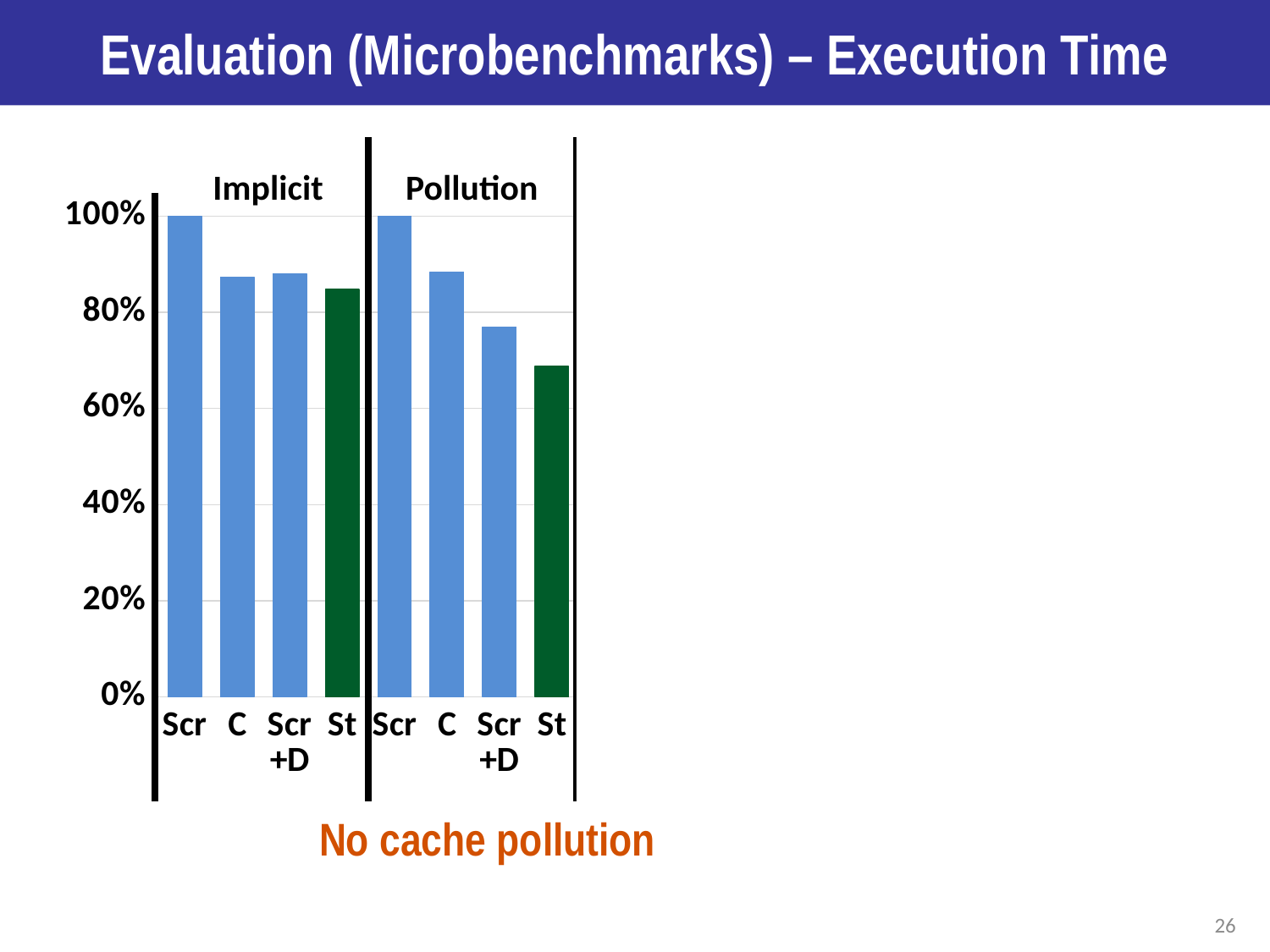
What is the value of the Scr bar in the Pollution group? 100% Do the bar values rise or fall from left to right within the Pollution group? fall What colour are the St bars in the chart? green What kind of chart is shown on the slide? bar chart How many bars are plotted in the chart? 8 Is the value for St in the Pollution group greater or less than 60%? greater Is the value for St in the Pollution group greater or less than 80%? less Is the value for St in the Implicit group greater or less than 80%? greater Which is larger, the St bar in the Implicit group or the St bar in the Pollution group? St in the Implicit group What are the two group labels shown above the bars? Implicit and Pollution Which bar is the lowest in the chart? St in the Pollution group What is the value of the Scr bar in the Implicit group? 100%